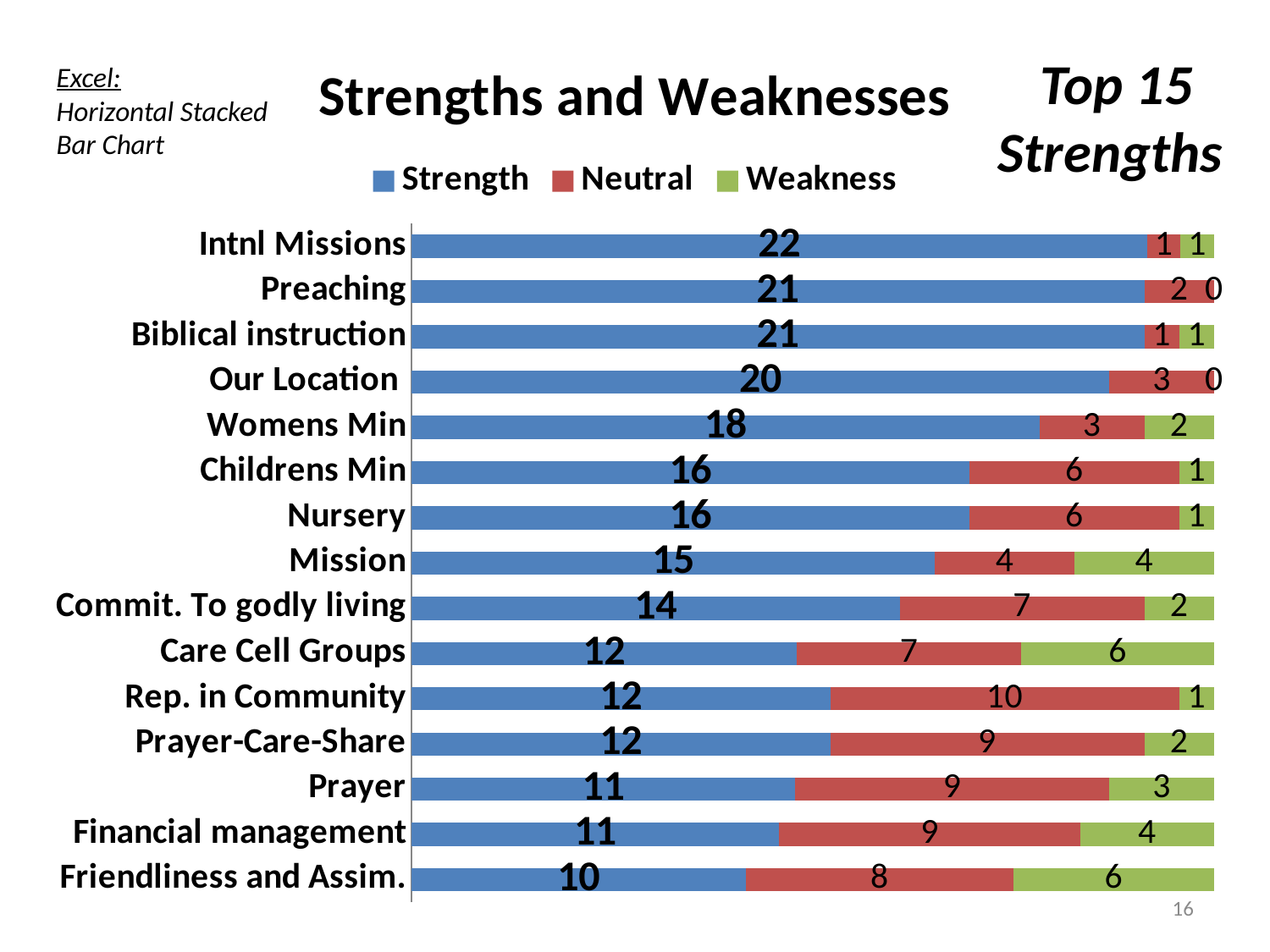
What is the difference between the Strength values for Intnl Missions and Friendliness and Assim.? 12 Which category has the highest Strength value? Intnl Missions How many categories are plotted in the chart? 15 What is the title of the chart? Strengths and Weaknesses Which has a larger Neutral value, Womens Min or Childrens Min? Childrens Min What is the total of the stacked bar for Mission? 23 What is the Weakness value for Care Cell Groups? 6 What type of chart is shown on the slide? Horizontal stacked bar chart Which category has the lowest Strength value? Friendliness and Assim. What is the Neutral value for Rep. in Community? 10 How many series does the legend list? 3 What is the Strength value for Intnl Missions? 22